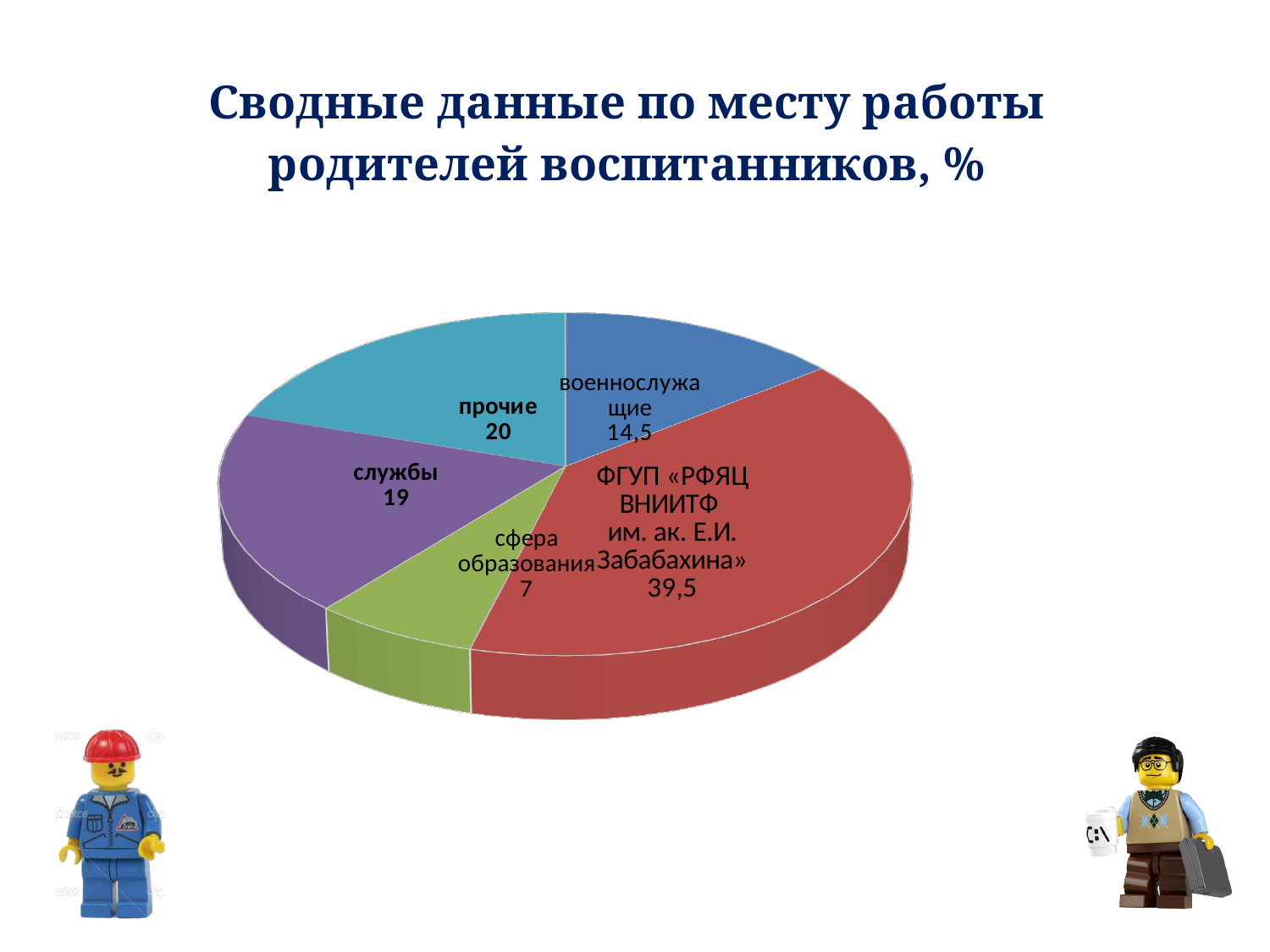
What is the value for сфера образования? 7 What is the value for ФГУП «РФЯЦ ВНИИТФ им. ак. Е.И. Забабахина»? 39,5 What is the value for военнослужащие? 14,5 What is the value for прочие? 20 What is the title of the chart on the slide? Сводные данные по месту работы родителей воспитанников, % What is the difference between the values for прочие and службы? 1 How many slices does the pie chart have? 5 Which category has the largest share of the pie? ФГУП «РФЯЦ ВНИИТФ им. ак. Е.И. Забабахина» Which category has the smallest share of the pie? сфера образования Which is larger, the value for военнослужащие or the value for службы? службы What kind of chart is shown on the slide? pie chart What is the value for службы? 19